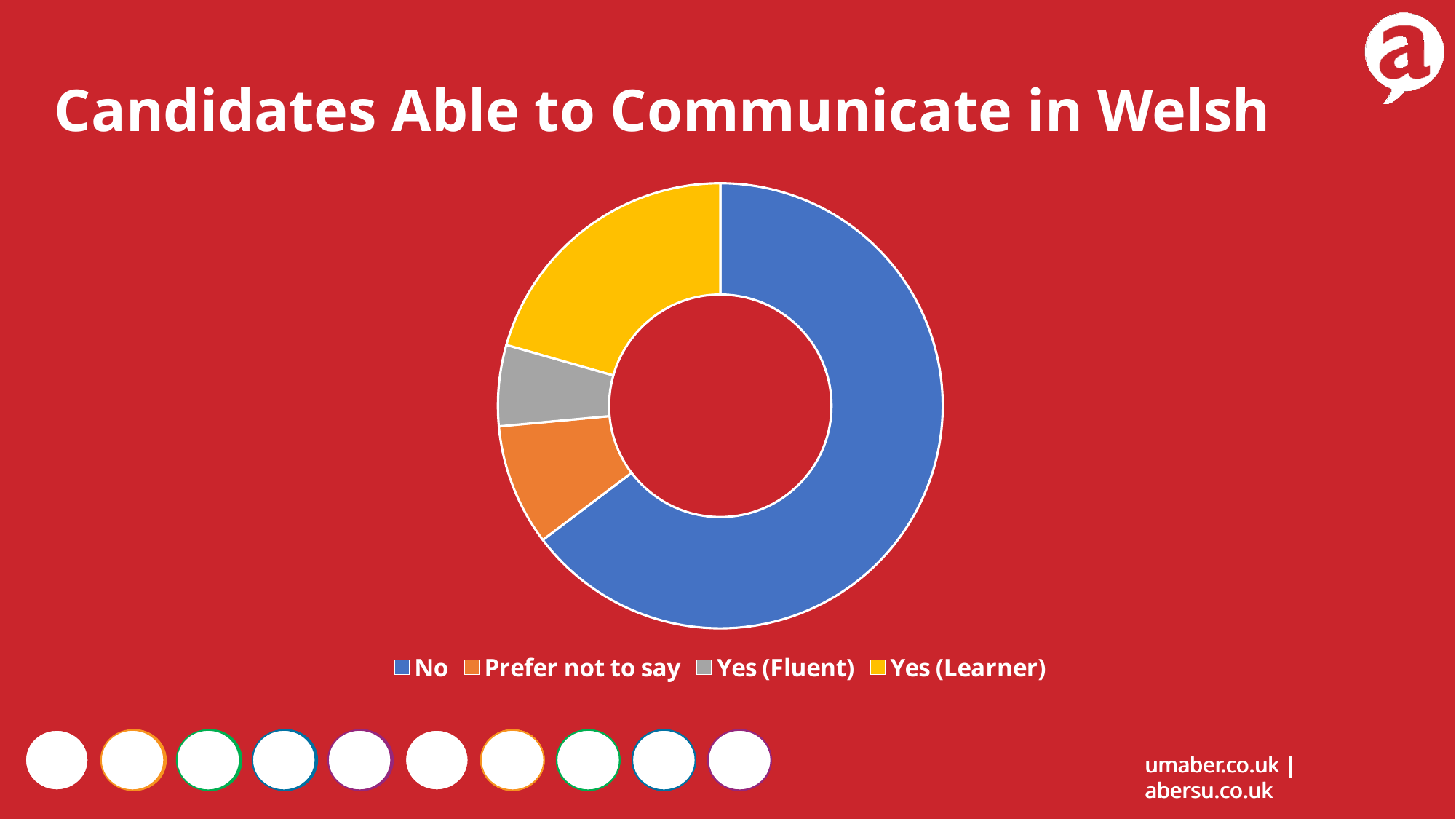
Which category has the largest share of the chart? No Does the No category account for more or less than half of the chart? More How many categories does the chart show? 4 Which is larger: the share for No or the share for Yes (Learner)? No Which category has the smallest share of the chart? Yes (Fluent) Which is larger: the share for Yes (Learner) or the share for Yes (Fluent)? Yes (Learner) Which colour represents the Yes (Learner) category in the chart? Yellow What is the title of the chart on the slide? Candidates Able to Communicate in Welsh What kind of chart is shown on the slide? Doughnut (pie) chart